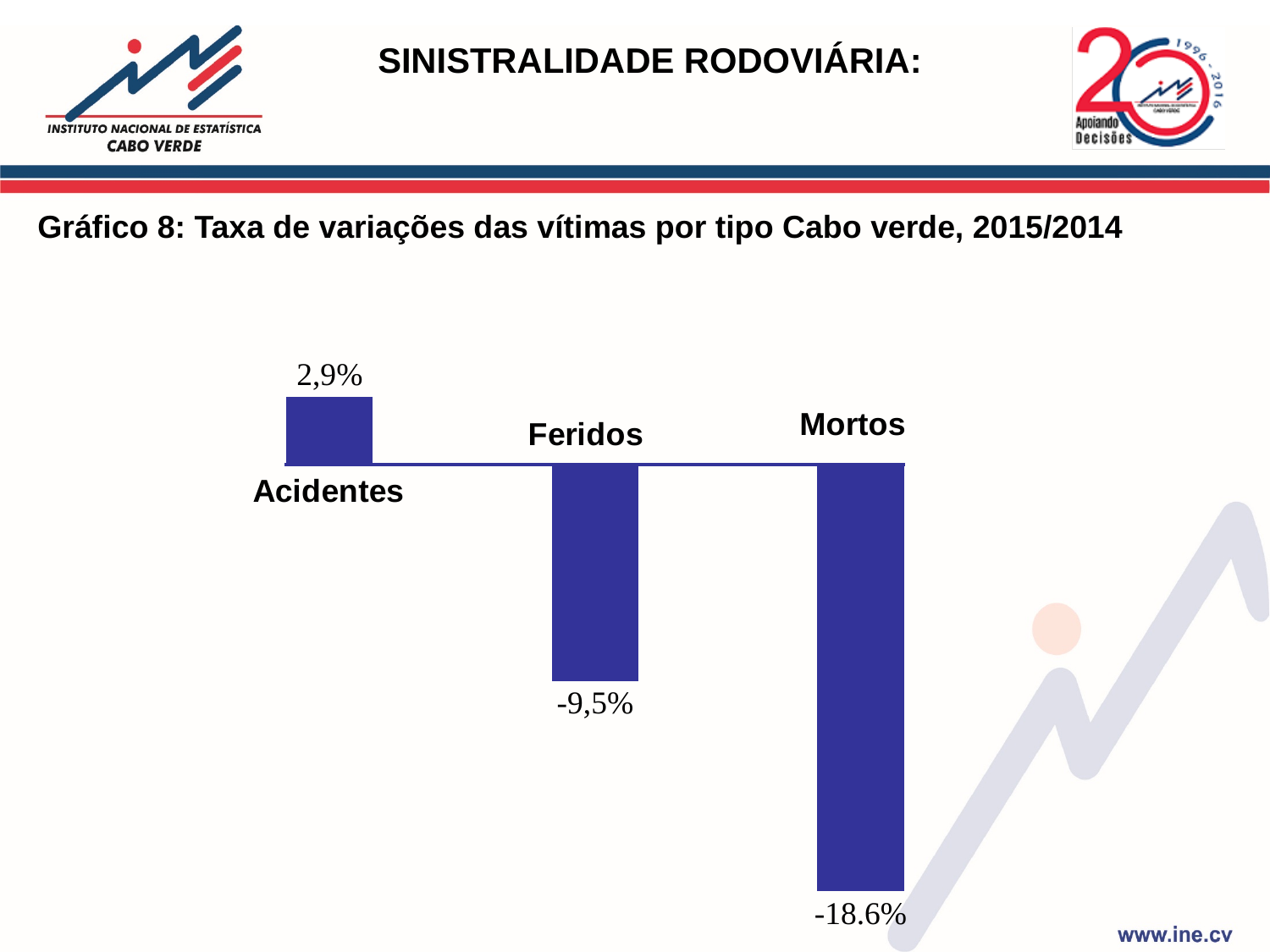
How many categories are shown in the chart? 3 What kind of chart is shown on the slide? Bar chart Which category is the only one with a positive value? Acidentes What is the title of the chart? Gráfico 8: Taxa de variações das vítimas por tipo Cabo verde, 2015/2014 Which category has the lowest value? Mortos What is the value shown for Feridos? -9,5% What is the value shown for Mortos? -18.6% Which is larger, the value for Feridos or the value for Mortos? Feridos Which category has the highest value? Acidentes Do the values rise or fall from Acidentes to Mortos along the x axis? Fall What is the value shown for Acidentes? 2,9%